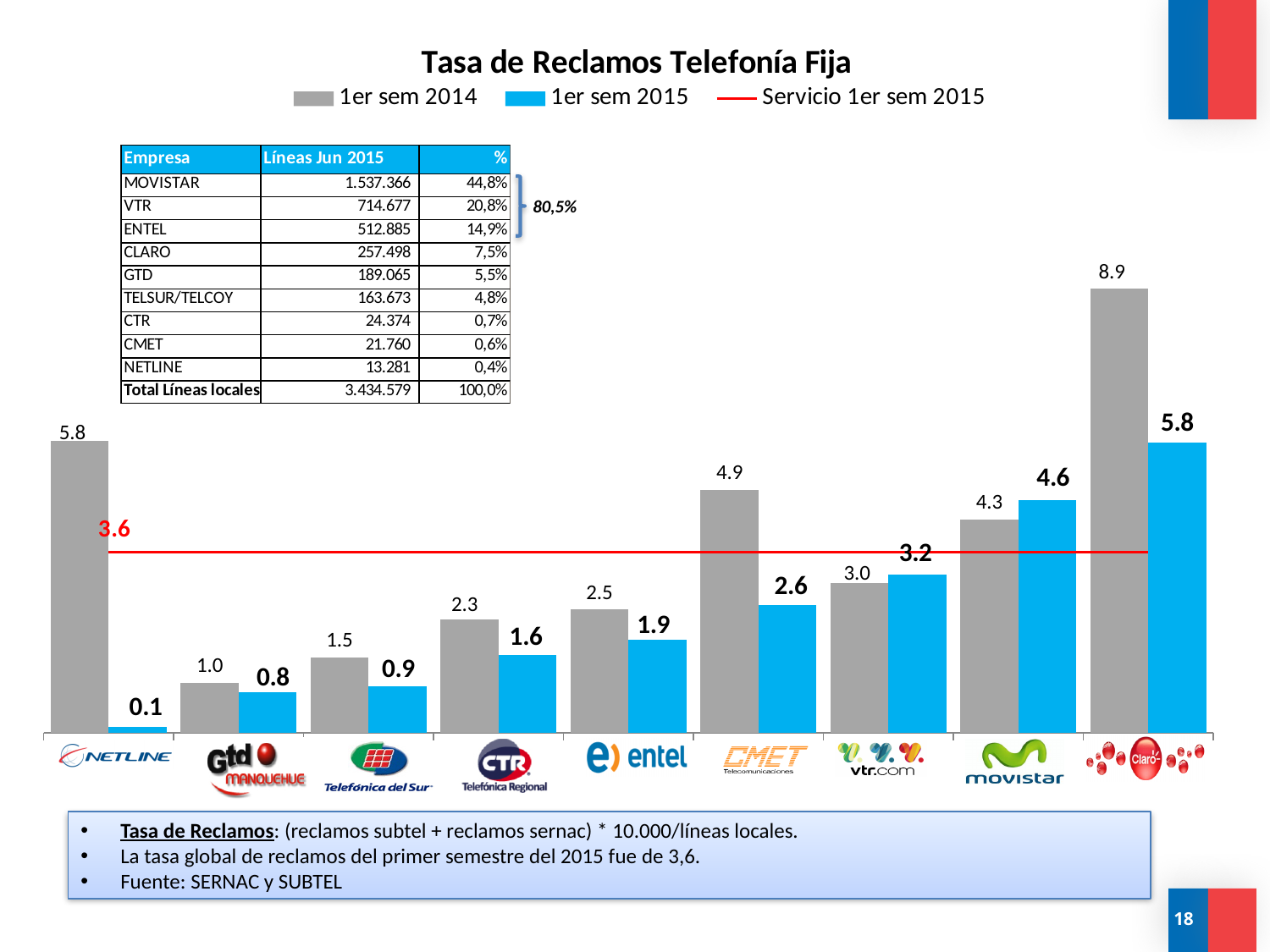
Which company has the lowest value in the 1er sem 2015 series? Netline What is the title of the chart? Tasa de Reclamos Telefonía Fija What type of chart is shown on the slide? combination bar and line chart How many series does the chart legend list? 3 What is the value for Netline in the 1er sem 2015 series? 0.1 What is the value for Entel in the 1er sem 2014 series? 2.5 What is the difference between the 1er sem 2014 and 1er sem 2015 values for Claro? 3.1 Which is larger for Movistar: the 1er sem 2014 value or the 1er sem 2015 value? 1er sem 2015 How many companies are shown along the x axis of the chart? 9 What is the value for Claro in the 1er sem 2015 series? 5.8 Which company has the highest value in the 1er sem 2014 series? Claro What value does the red 'Servicio 1er sem 2015' line mark on the chart? 3.6